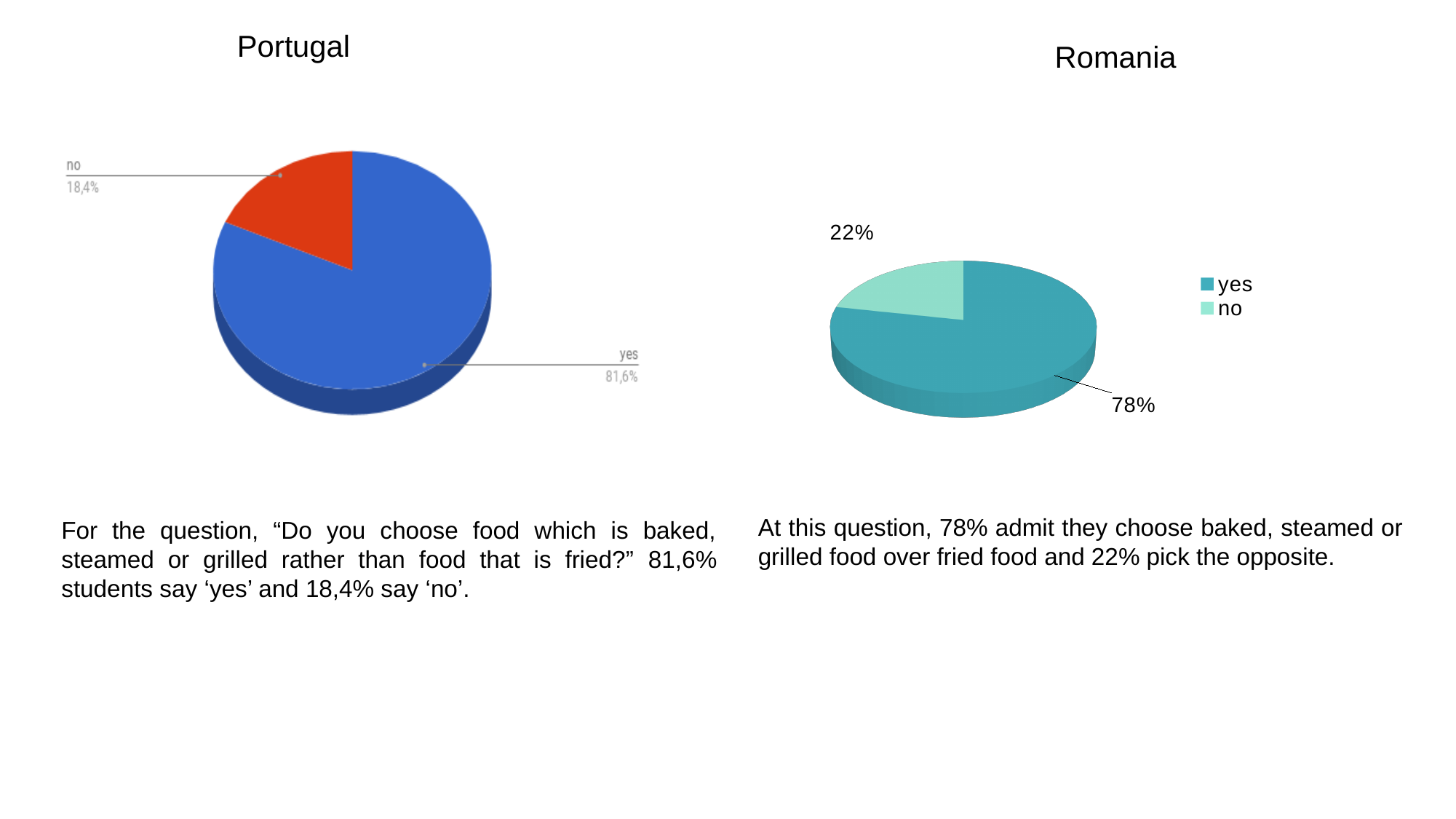
In the Romania chart, what percentage answered 'yes'? 78% In the Romania chart, how many entries does the legend list? 2 In the Portugal chart, what percentage of students answered 'no'? 18,4% How many slices does the Portugal pie chart have? 2 In the Romania chart, what is the difference between the 'yes' and 'no' percentages? 56% Which chart has the larger 'no' share, Portugal or Romania? Romania In the Portugal chart, what is the difference between the 'yes' and 'no' percentages? 63,2% In the Romania chart, which answer has the smallest slice? no In the Portugal chart, what percentage of students answered 'yes'? 81,6% What kind of chart is the Romania chart? pie chart In the Romania chart, what percentage answered 'no'? 22% In the Portugal chart, which answer has the largest slice? yes